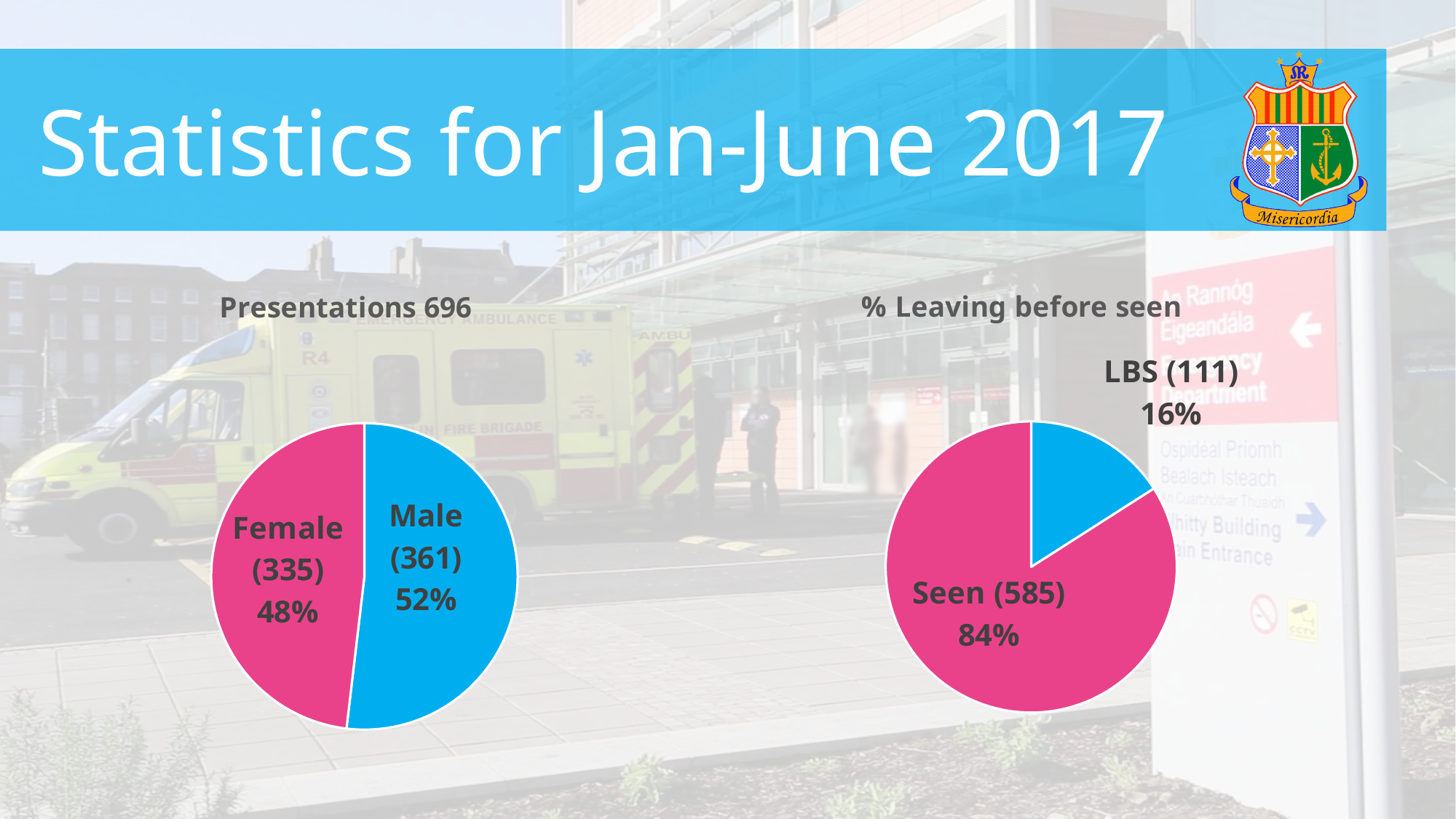
In the '% Leaving before seen' chart, what share of the pie is LBS? 16% What is the title of the chart on the left of the slide? Presentations 696 In the 'Presentations 696' chart, how many slices does the pie have? 2 In the '% Leaving before seen' chart, how many patients were Seen? 585 In the 'Presentations 696' chart, what is the difference between the Male and Female counts? 26 In the '% Leaving before seen' chart, what colour is the LBS slice? Blue In the 'Presentations 696' chart, what percentage of presentations were Female? 48% In the 'Presentations 696' chart, which category has the larger count, Male or Female? Male In the '% Leaving before seen' chart, what is the difference between the Seen and LBS counts? 474 In the 'Presentations 696' chart, how many presentations were Male? 361 What kind of chart is the 'Presentations 696' chart? Pie chart In the '% Leaving before seen' chart, which category is the largest? Seen